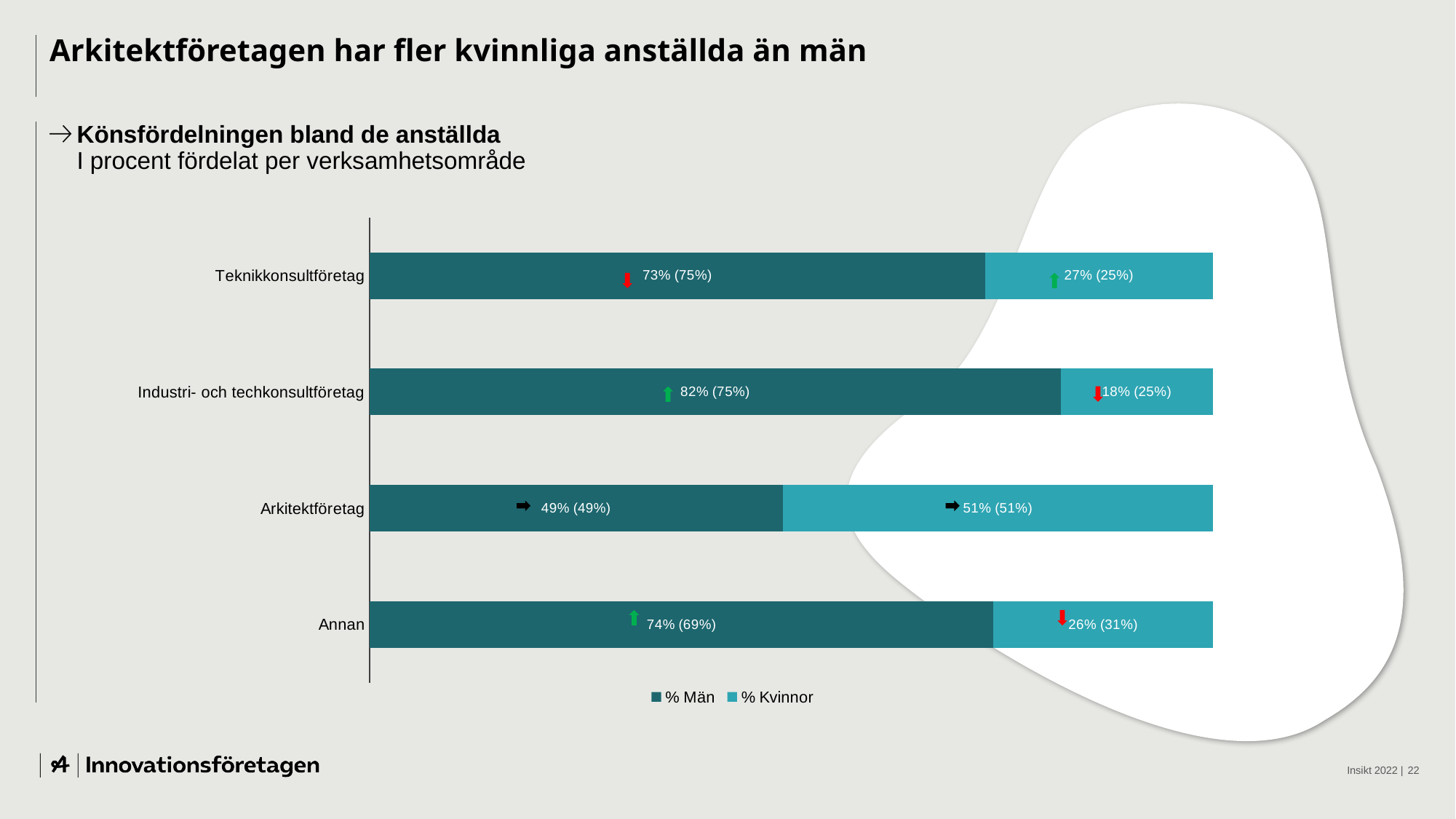
What is the % Kvinnor value for Arkitektföretag? 51% How many categories are shown in the chart? 4 What is the % Män value for Teknikkonsultföretag? 73% What value is shown in parentheses for % Kvinnor for Annan? 31% Which category has the highest % Män value? Industri- och techkonsultföretag What is the difference between the % Män values for Industri- och techkonsultföretag and Arkitektföretag? 33 percentage points Which is larger for Arkitektföretag, % Män or % Kvinnor? % Kvinnor What kind of chart is shown on the slide? Stacked bar chart How many series does the legend list? 2 Which category has the lowest % Kvinnor value? Industri- och techkonsultföretag What is the % Kvinnor value for Industri- och techkonsultföretag? 18% What is the % Män value for Annan? 74%